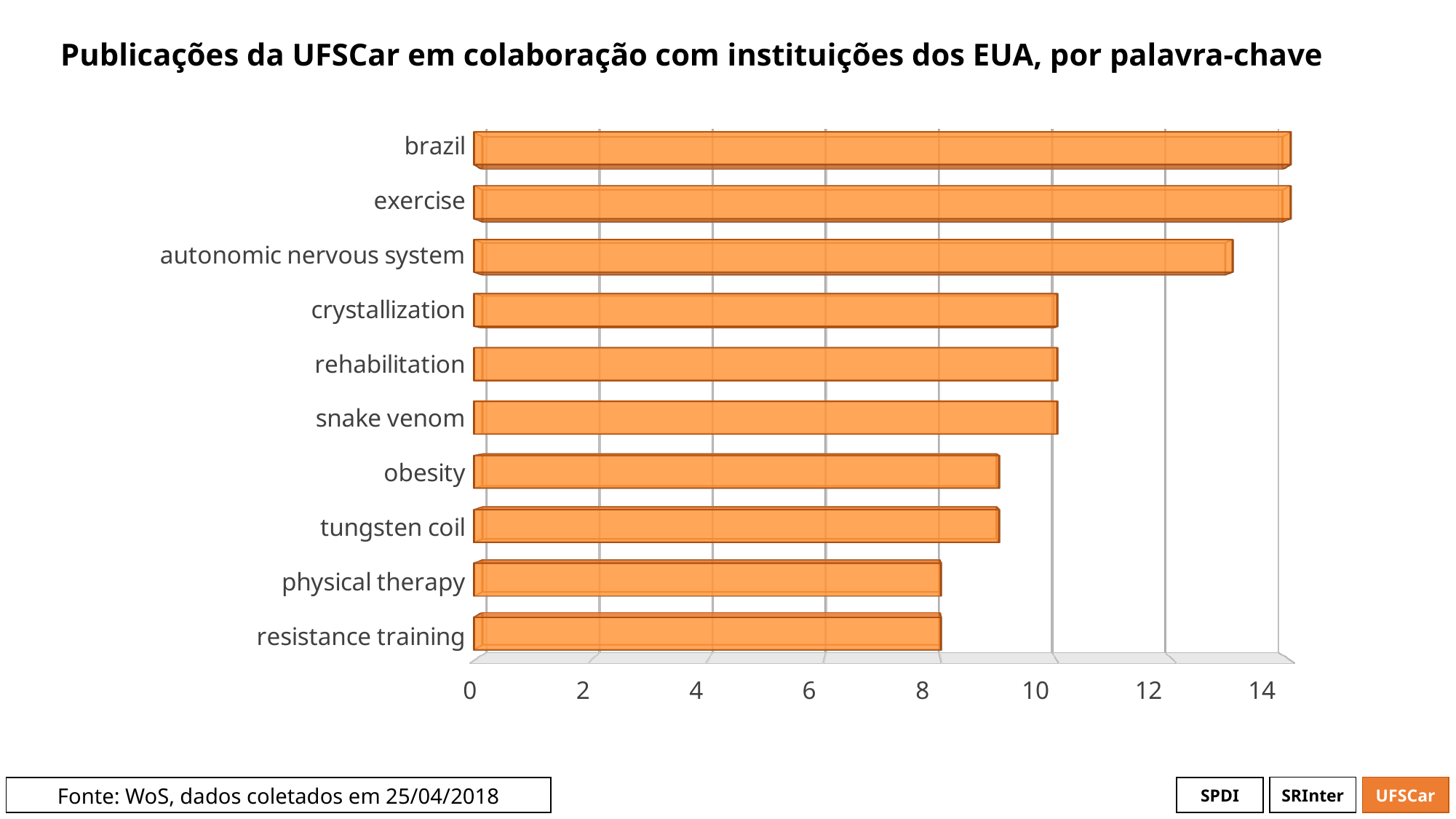
Is the value for resistance training greater or less than 6? greater Is the value for crystallization greater or less than 12? less Is the value for autonomic nervous system greater or less than 12? greater What is the source of the data stated on the slide? WoS, dados coletados em 25/04/2018 What is the title of the chart? Publicações da UFSCar em colaboração com instituições dos EUA, por palavra-chave Which has a larger value, brazil or crystallization? brazil How many keywords (categories) are plotted in the chart? 10 What kind of chart is shown on the slide? bar chart Which has a larger value, autonomic nervous system or obesity? autonomic nervous system